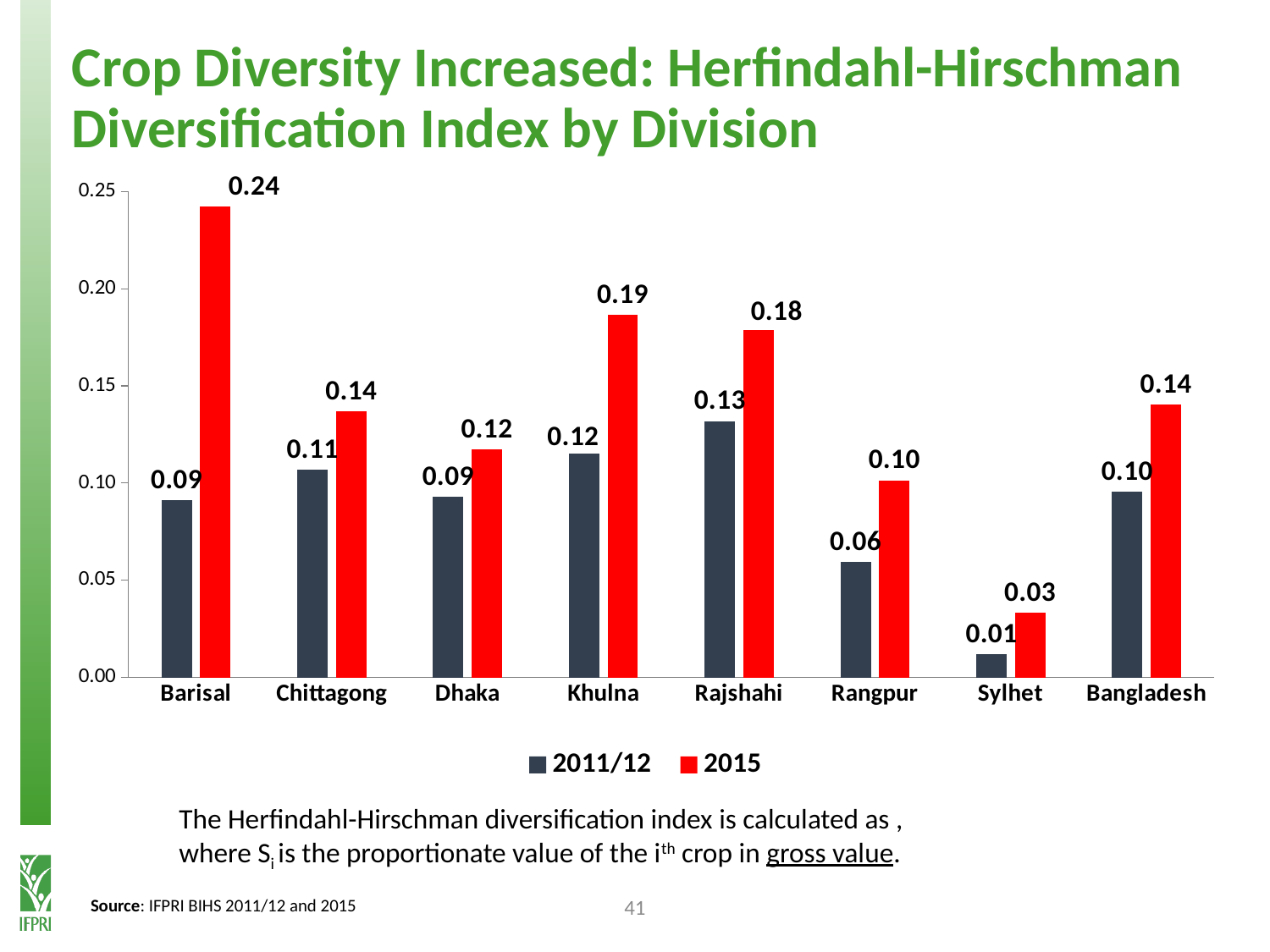
What is the 2011/12 value for Rajshahi? 0.13 Which division has the lowest 2011/12 value? Sylhet What is the 2011/12 value for Bangladesh? 0.10 How many categories are shown on the x axis? 8 What is the 2015 value for Khulna? 0.19 Which division has the highest 2015 value? Barisal Is the 2015 value for Rajshahi greater or less than 0.15? greater What is the 2015 value for Barisal? 0.24 What is the difference between the 2015 and 2011/12 values for Barisal? 0.15 How many series does the legend list? 2 Which is larger, the 2015 value for Rangpur or the 2015 value for Dhaka? Dhaka What kind of chart is shown on the slide? bar chart